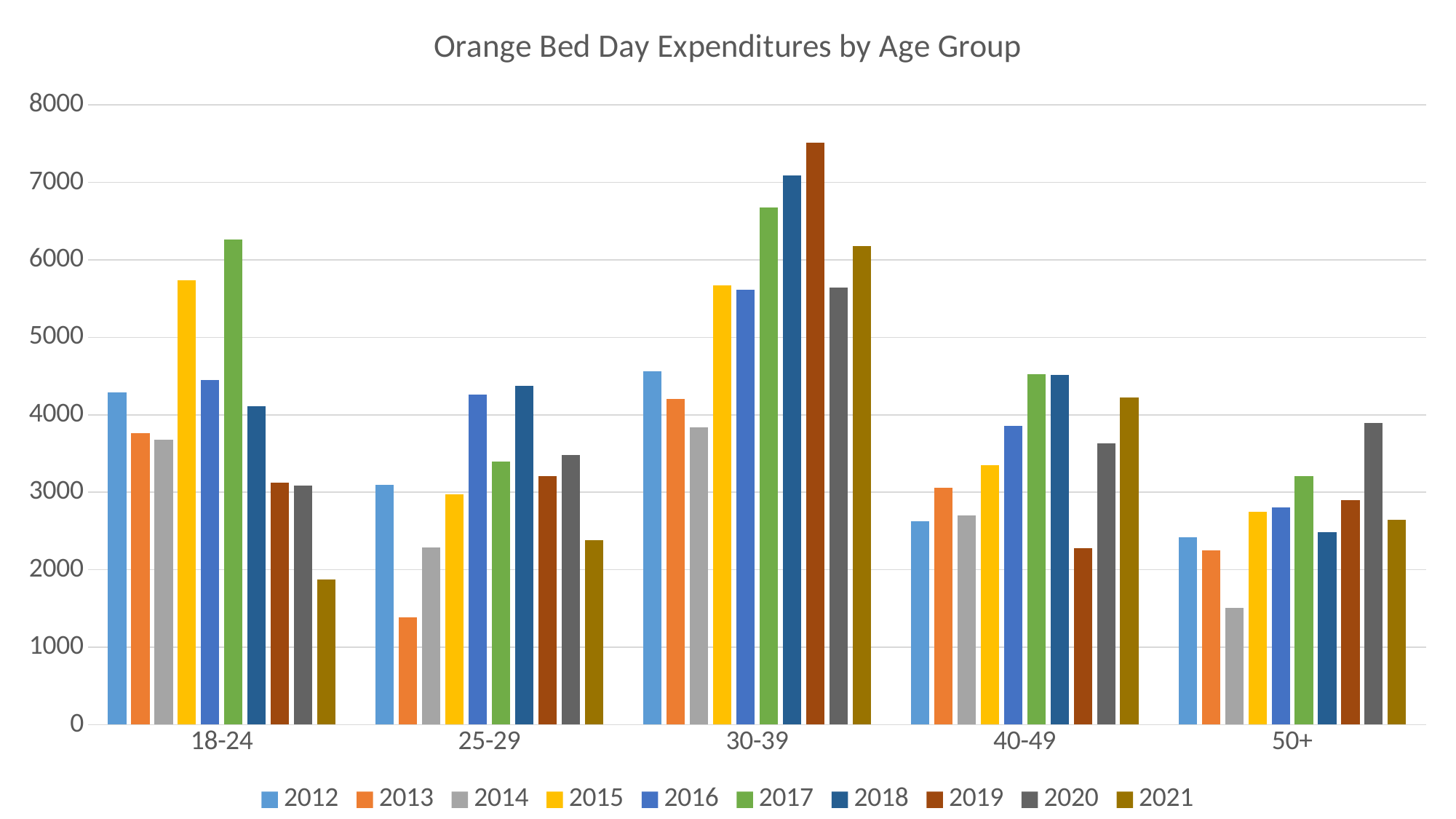
Which age group has the highest 2019 bar? 30-39 Is the 2019 value for the 30-39 age group greater or less than 7000? greater What kind of chart is shown on the slide? bar chart Within the 18-24 age group, which year has the highest bar? 2017 How many series (years) does the legend list? 10 Is the 2014 value for the 50+ age group greater or less than 2000? less Within the 50+ age group, which year has the highest bar? 2020 In the 18-24 age group, which is larger: the 2015 value or the 2017 value? 2017 What is the title of the chart? Orange Bed Day Expenditures by Age Group How many age groups are shown on the x axis? 5 Is the 2021 value for the 18-24 age group greater or less than 2000? less Within the 25-29 age group, which year has the lowest bar? 2013